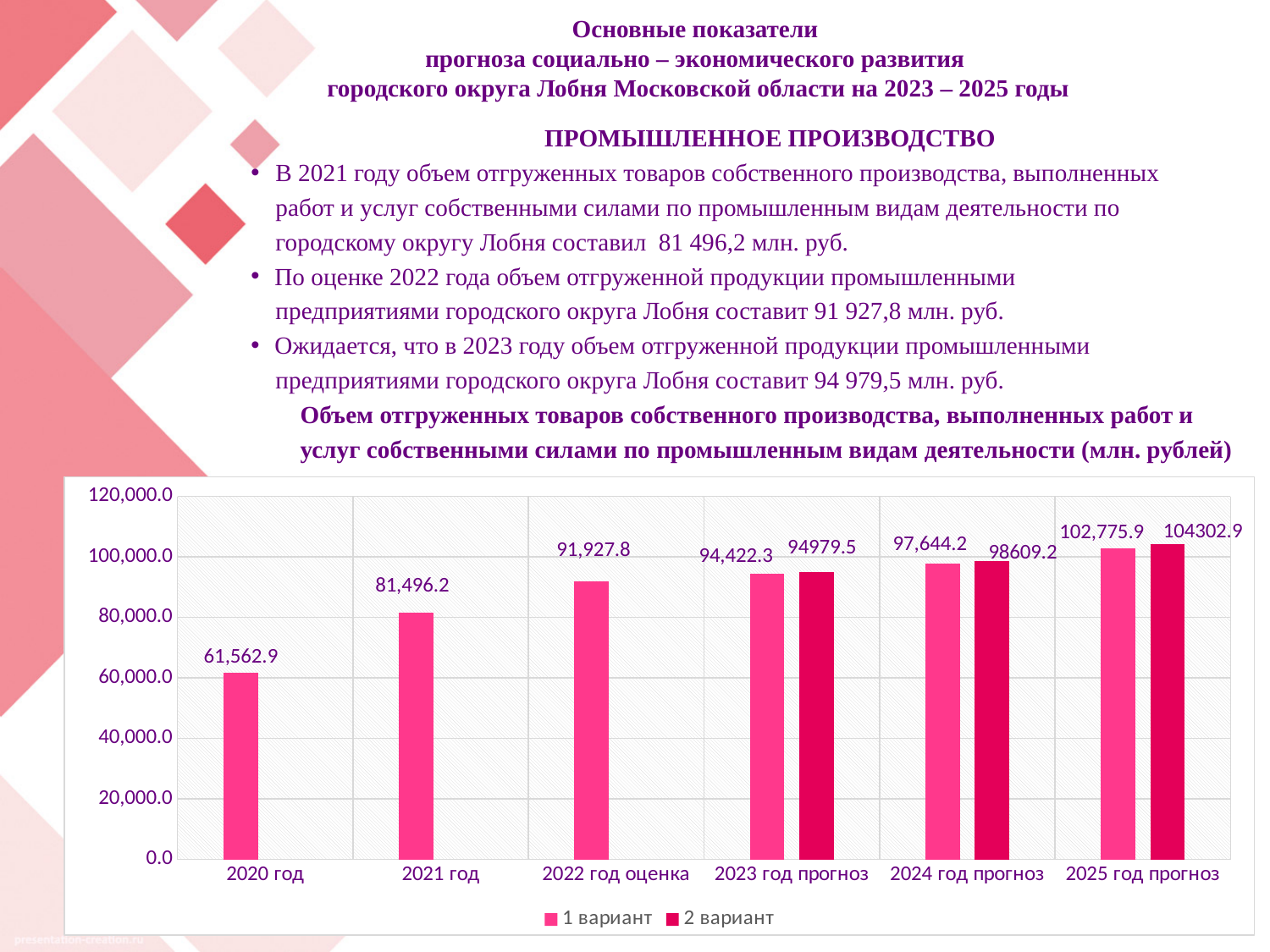
Is the value for 2022 год оценка greater or less than 100,000.0? less What kind of chart is shown on the slide? bar chart Which is larger for 2023 год прогноз: the 1 вариант value or the 2 вариант value? 2 вариант What is the difference between the 1 вариант values for 2021 год and 2020 год? 19,933.3 What is the value for 2020 год in the chart? 61,562.9 What is the value of the 2 вариант series for 2025 год прогноз? 104302.9 Which category has the lowest value in the chart? 2020 год How many series does the chart legend list? 2 Which category has the highest value in the chart? 2025 год прогноз Do the 1 вариант values rise or fall from 2020 год to 2025 год прогноз? rise What is the value of the 1 вариант series for 2024 год прогноз? 97,644.2 How many categories are shown on the x axis of the chart? 6